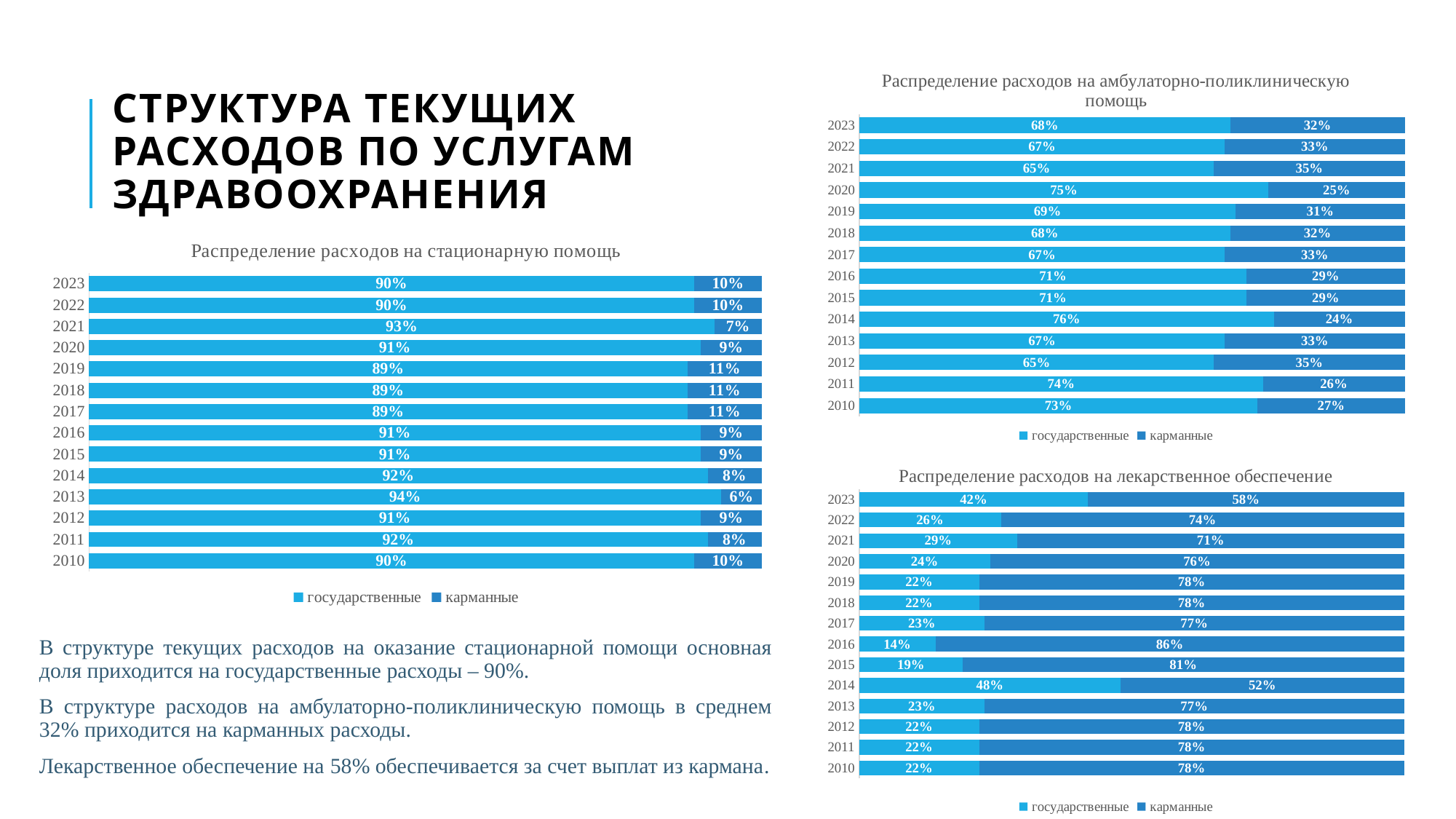
In the chart 'Распределение расходов на стационарную помощь', what is the value for карманные in 2019? 11% How many series does the legend of the chart 'Распределение расходов на амбулаторно-поликлиническую помощь' list? 2 How many years are shown in the chart 'Распределение расходов на стационарную помощь'? 14 In the chart 'Распределение расходов на лекарственное обеспечение', which year has the lowest value for государственные? 2016 In the chart 'Распределение расходов на лекарственное обеспечение', what is the value for государственные in 2023? 42% In the chart 'Распределение расходов на стационарную помощь', which year has the highest value for карманные? 2019, 2018 and 2017 (11%) In the chart 'Распределение расходов на лекарственное обеспечение', which is larger: the карманные value for 2014 or for 2015? 2015 In the chart 'Распределение расходов на амбулаторно-поликлиническую помощь', what is the value for карманные in 2020? 25% In the chart 'Распределение расходов на амбулаторно-поликлиническую помощь', what is the difference between the государственные values for 2014 and 2012? 11% In the chart 'Распределение расходов на амбулаторно-поликлиническую помощь', which year has the highest value for государственные? 2014 In the chart 'Распределение расходов на лекарственное обеспечение', what is the total of the stacked bar for 2022? 100% In the chart 'Распределение расходов на стационарную помощь', what is the value for государственные in 2013? 94%